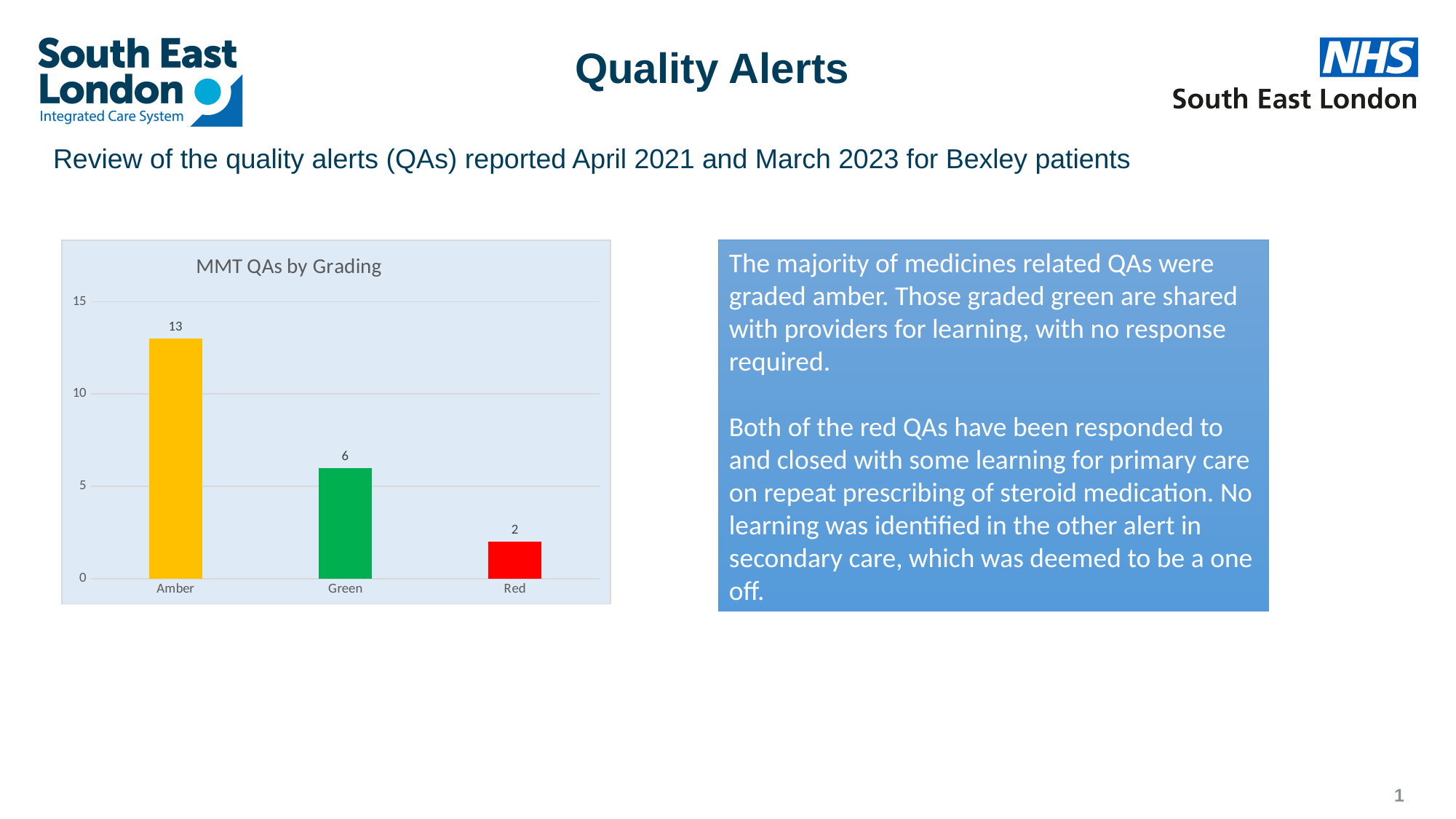
What kind of chart is shown on the slide? Bar chart What is the value for Green in the MMT QAs by Grading chart? 6 What is the difference between the Amber and Green values? 7 Is the value for Amber greater or less than 10? greater What is the title of the chart? MMT QAs by Grading Which grading has the lowest number of QAs? Red What is the value for Red in the MMT QAs by Grading chart? 2 What is the difference between the Green and Red values? 4 What is the value for Amber in the MMT QAs by Grading chart? 13 Which grading has the highest number of QAs? Amber Which is larger, the value for Green or the value for Red? Green How many grading categories are shown in the chart? 3